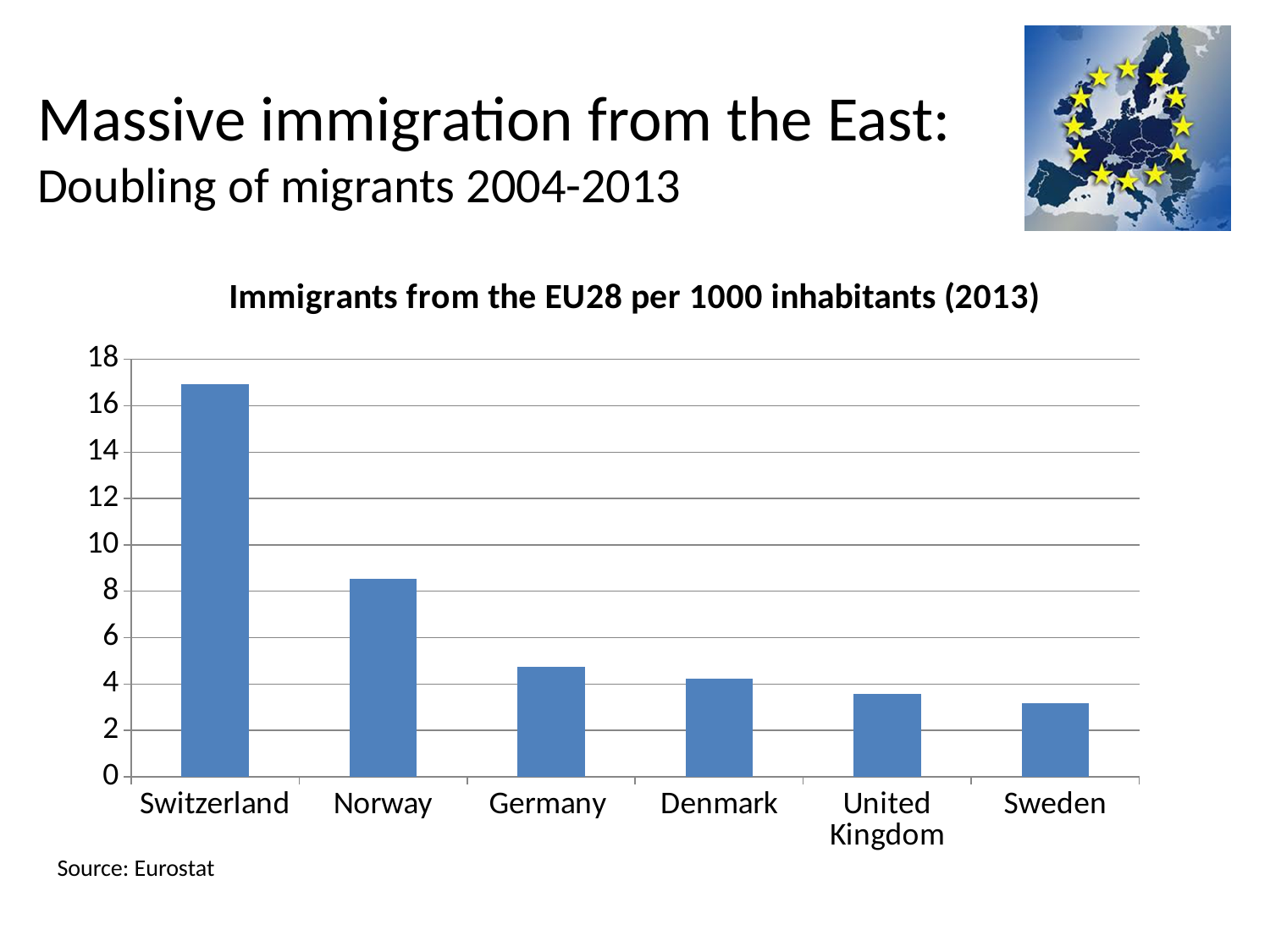
Is the value for Norway greater or less than 8? greater What is the title of the chart? Immigrants from the EU28 per 1000 inhabitants (2013) Which country has the highest value in the chart? Switzerland Do the values rise or fall moving from left to right across the countries? fall Which has a higher value, Switzerland or Norway? Switzerland How many countries are shown in the chart? 6 Is the value for Norway greater or less than 10? less Is the value for Switzerland greater or less than 16? greater What type of chart is shown on the slide? bar chart